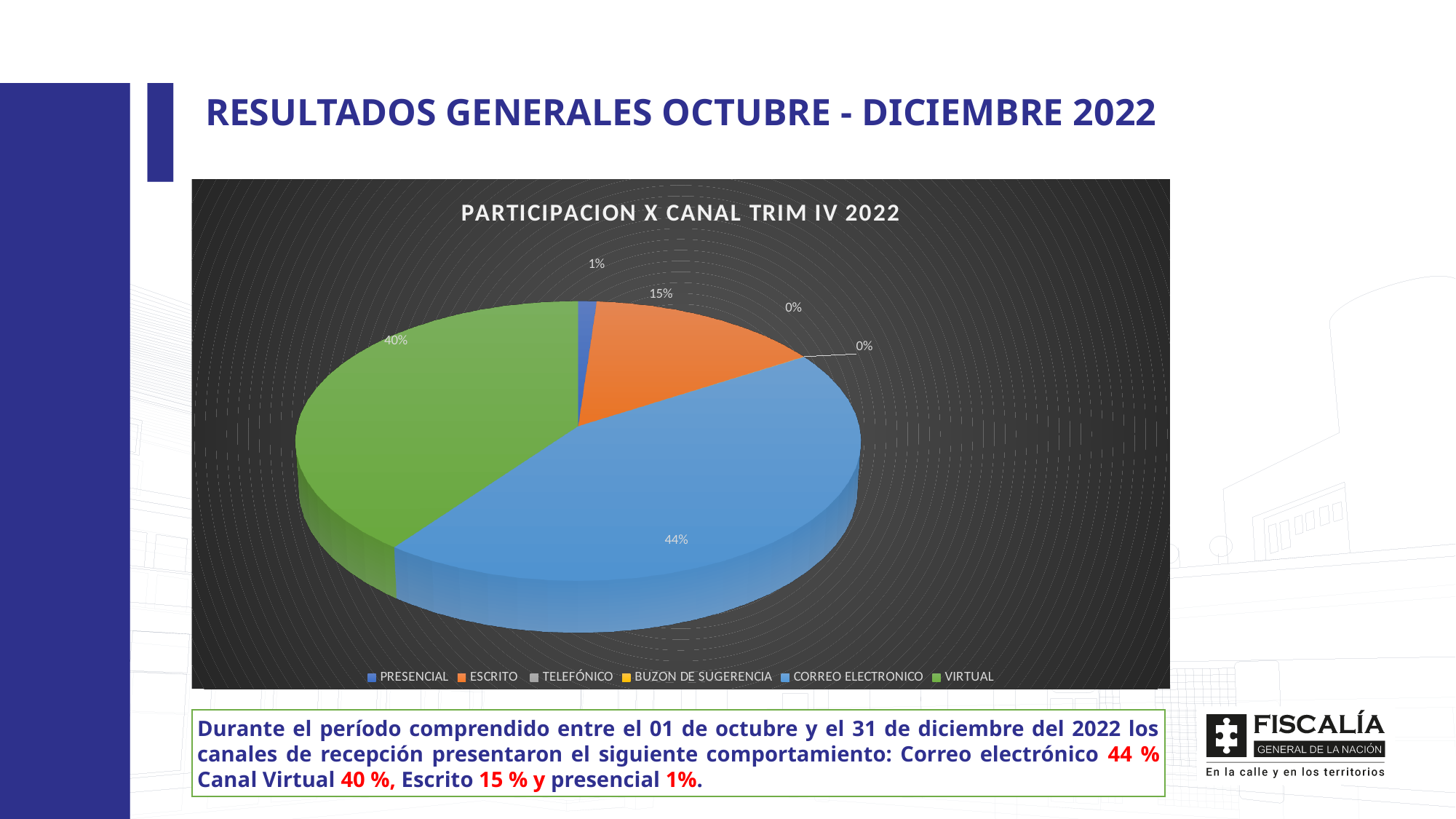
What share of the pie does TELEFÓNICO represent? 0% How many categories does the legend list? 6 Which is larger, the share for ESCRITO or the share for PRESENCIAL? ESCRITO What share of the pie does CORREO ELECTRONICO represent? 44% What is the title of the chart? PARTICIPACION X CANAL TRIM IV 2022 What share of the pie does ESCRITO represent? 15% What colour represents VIRTUAL in the chart? Green What type of chart is shown on the slide? Pie chart What is the difference in percentage points between the CORREO ELECTRONICO share and the VIRTUAL share? 4 Which channel has the largest share of the pie? CORREO ELECTRONICO